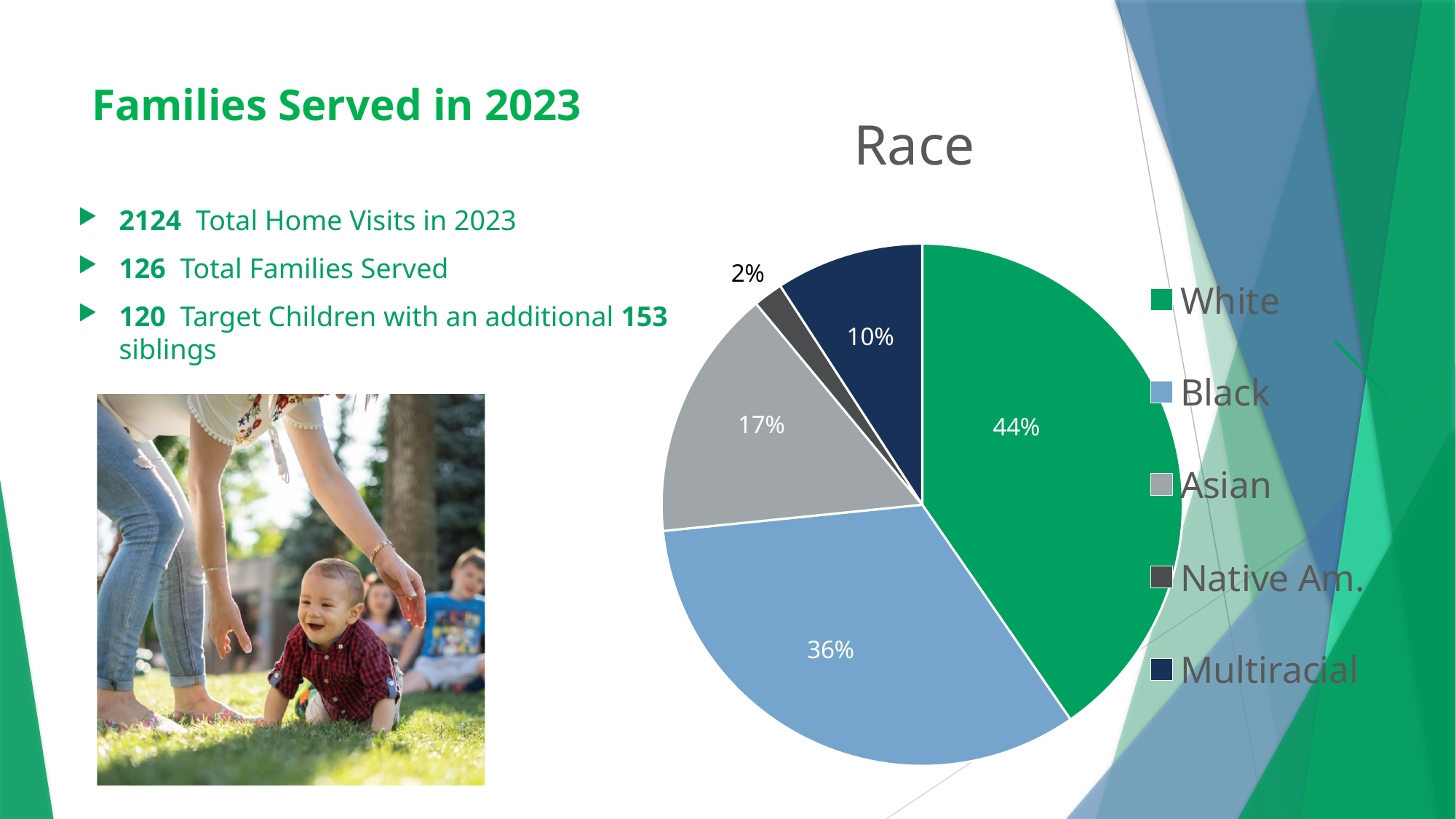
What percentage of the pie is Multiracial? 10% Which category has the smallest share of the pie? Native Am. What percentage of the pie is Native Am.? 2% What percentage of the pie is Asian? 17% What type of chart is shown on the slide? pie chart Which category has the largest share of the pie? White What is the title of the chart? Race Which slice is larger, Asian or Multiracial? Asian How many categories does the legend list? 5 What is the difference in percentage points between the White and Black slices? 8 What percentage of the pie is White? 44% What percentage of the pie is Black? 36%